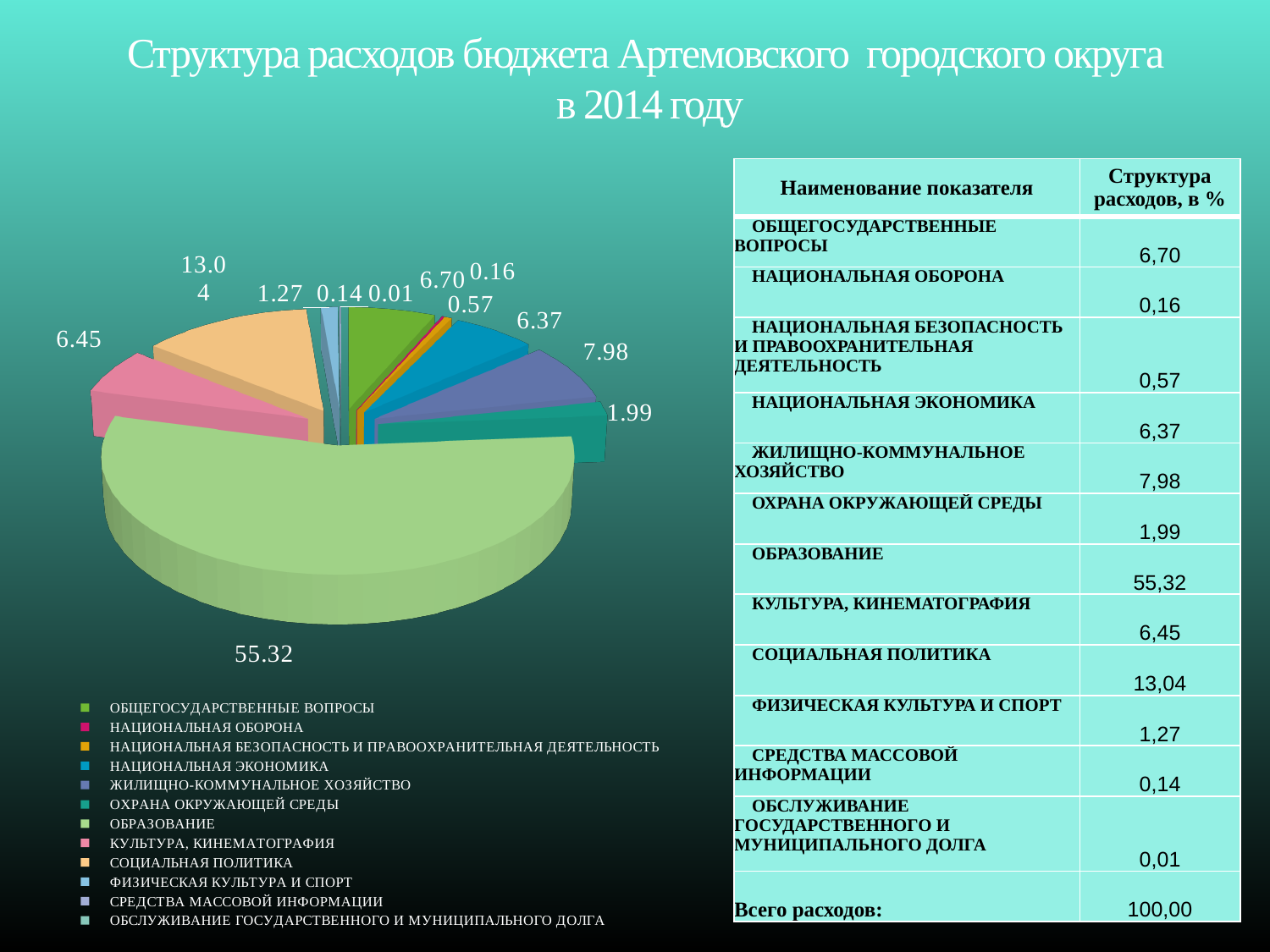
Which is larger in the pie chart: ЖИЛИЩНО-КОММУНАЛЬНОЕ ХОЗЯЙСТВО or НАЦИОНАЛЬНАЯ ЭКОНОМИКА? ЖИЛИЩНО-КОММУНАЛЬНОЕ ХОЗЯЙСТВО Which category has the smallest slice of the pie chart? ОБСЛУЖИВАНИЕ ГОСУДАРСТВЕННОГО И МУНИЦИПАЛЬНОГО ДОЛГА Which category has the largest slice of the pie chart? ОБРАЗОВАНИЕ What is the value shown for СОЦИАЛЬНАЯ ПОЛИТИКА in the pie chart? 13.04 How many categories does the pie chart legend list? 12 What is the title of the slide containing the pie chart? Структура расходов бюджета Артемовского городского округа в 2014 году What is the value shown for ОХРАНА ОКРУЖАЮЩЕЙ СРЕДЫ in the pie chart? 1.99 What kind of chart is shown on the slide? pie chart What is the value shown for ЖИЛИЩНО-КОММУНАЛЬНОЕ ХОЗЯЙСТВО in the pie chart? 7.98 What is the value shown for ОБРАЗОВАНИЕ in the pie chart? 55.32 What is the difference between the values for СОЦИАЛЬНАЯ ПОЛИТИКА and КУЛЬТУРА, КИНЕМАТОГРАФИЯ in the pie chart? 6.59 What is the value shown for НАЦИОНАЛЬНАЯ ОБОРОНА in the pie chart? 0.16